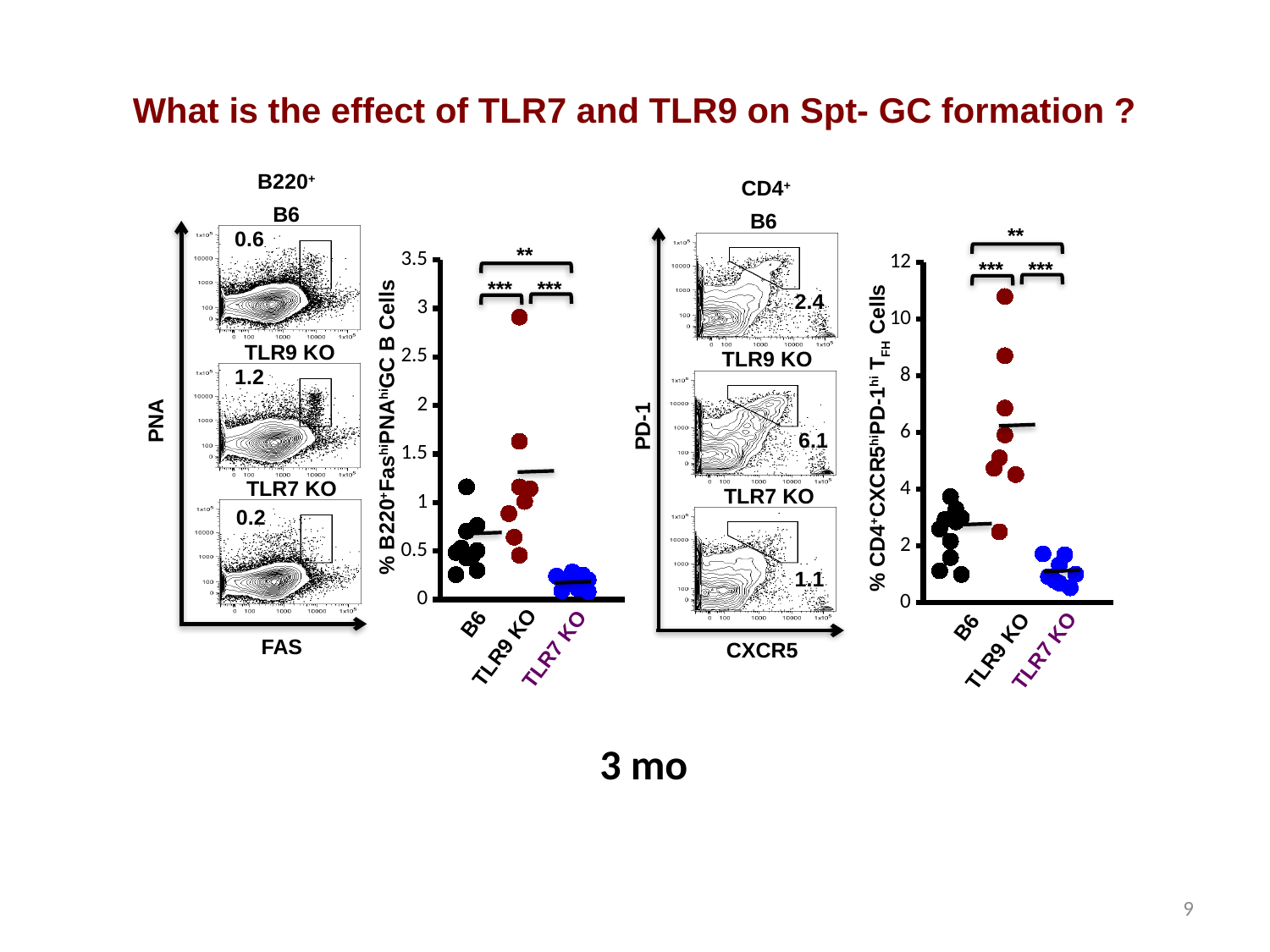
In the CD4+ flow cytometry panels, what gate percentage is printed for TLR7 KO? 1.1 What kind of chart is the plot labelled % B220+Fas hi PNA hi GC B Cells? Dot (scatter) plot In the left dot plot (% B220+Fas hi PNA hi GC B Cells), are the TLR7 KO points greater or less than 0.5? less In the CD4+ flow cytometry panels, what is the difference between the TLR9 KO gate percentage and the B6 gate percentage? 3.7 In the left dot plot (% B220+Fas hi PNA hi GC B Cells), which group has the highest values? TLR9 KO In the right dot plot (% CD4+CXCR5 hi PD-1 hi TFH Cells), are the TLR7 KO points greater or less than 2? less In the B220+ flow cytometry panels on the left, what gate percentage is printed for TLR9 KO? 1.2 In the right dot plot (% CD4+CXCR5 hi PD-1 hi TFH Cells), is the highest TLR9 KO point greater or less than 10? greater In the left dot plot (% B220+Fas hi PNA hi GC B Cells), which group has the lowest values? TLR7 KO In the right dot plot (% CD4+CXCR5 hi PD-1 hi TFH Cells), which group has the highest values? TLR9 KO In the left dot plot (% B220+Fas hi PNA hi GC B Cells), how many groups are shown on the x axis? 3